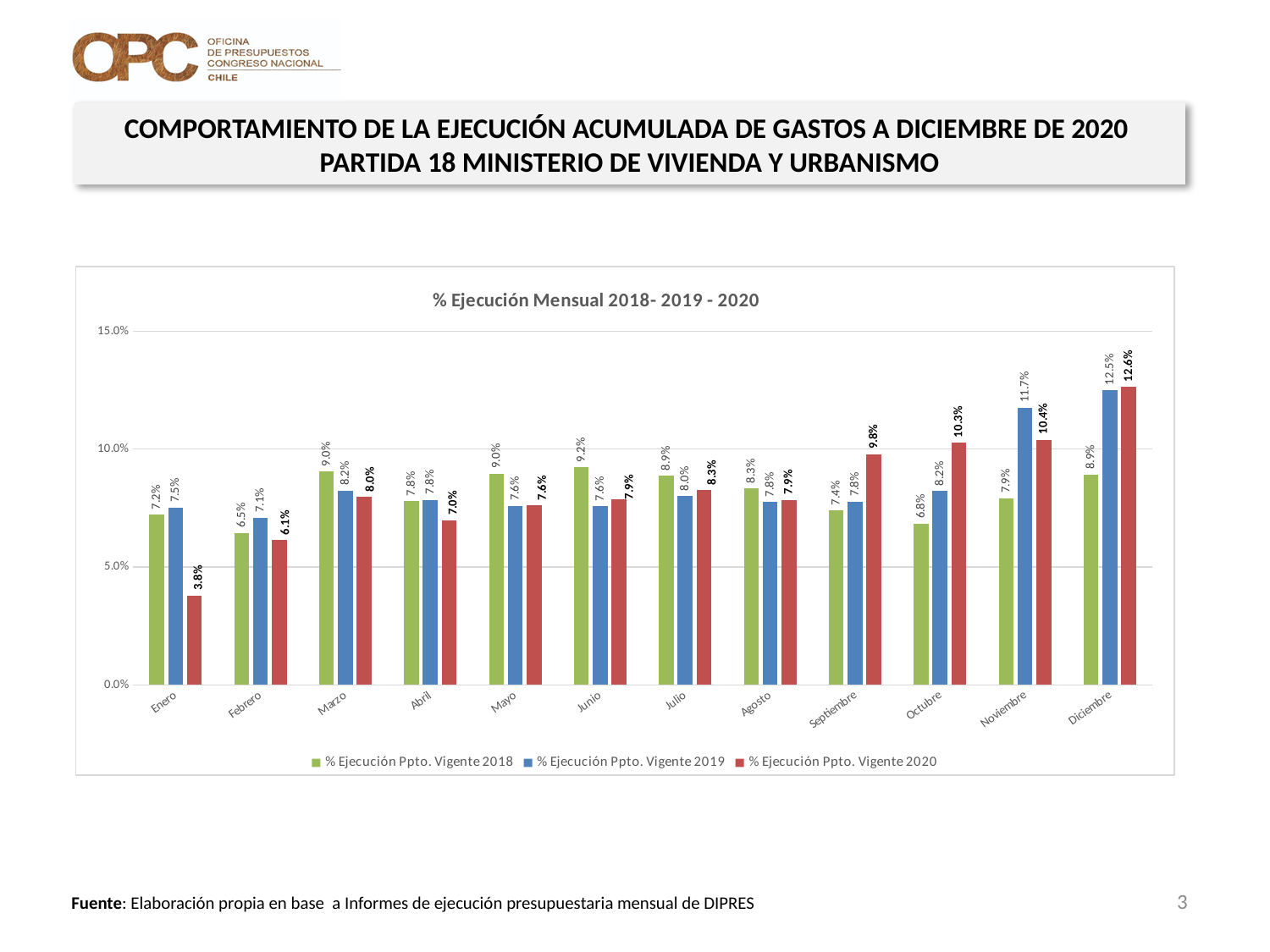
How many series does the legend list? 3 What is the value for % Ejecución Ppto. Vigente 2019 in Noviembre? 11.7% Is the value for % Ejecución Ppto. Vigente 2020 in Enero greater or less than 5.0%? less What is the difference between the 2019 and 2018 values in Diciembre? 3.6% Which month has the lowest value for % Ejecución Ppto. Vigente 2018? Octubre How many months are shown on the x axis? 12 What is the title of the chart? % Ejecución Mensual 2018- 2019 - 2020 In Octubre, which is larger: the 2020 value or the 2018 value? 2020 What is the value for % Ejecución Ppto. Vigente 2018 in Junio? 9.2% What kind of chart is shown? Bar chart Which month has the highest value for % Ejecución Ppto. Vigente 2020? Diciembre What is the value for % Ejecución Ppto. Vigente 2020 in Enero? 3.8%